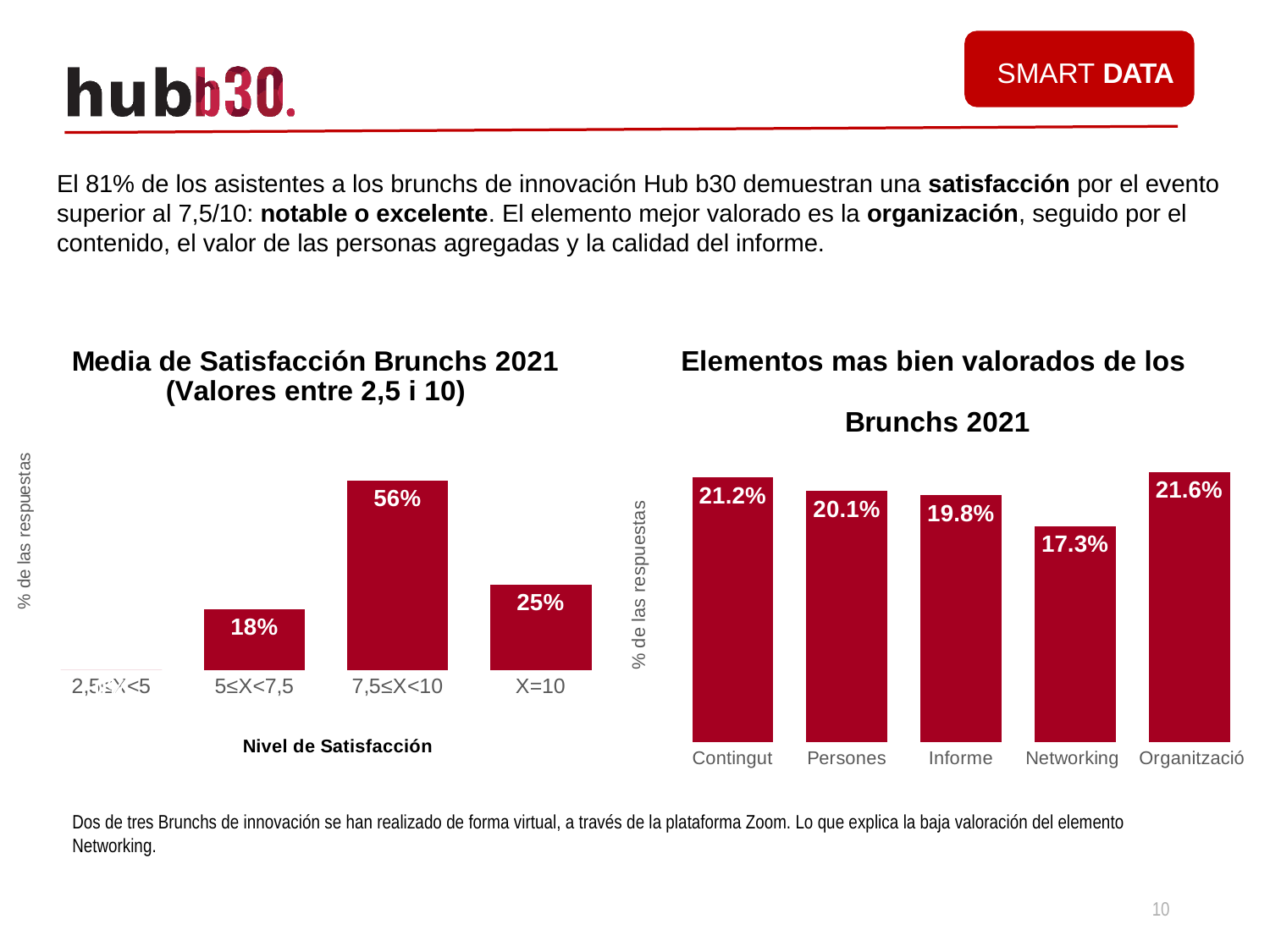
In the 'Elementos mas bien valorados de los Brunchs 2021' chart, what is the value for Informe? 19.8% In the 'Elementos mas bien valorados de los Brunchs 2021' chart, what is the value for Networking? 17.3% In the 'Elementos mas bien valorados de los Brunchs 2021' chart, which element has the highest value? Organització In the 'Media de Satisfacción Brunchs 2021' chart, what percentage of responses fall in the 7,5≤X<10 category? 56% In the 'Media de Satisfacción Brunchs 2021' chart, what is the value for the X=10 category? 25% In the 'Media de Satisfacción Brunchs 2021' chart, what is the difference between the 7,5≤X<10 and 5≤X<7,5 values? 38% In the 'Elementos mas bien valorados de los Brunchs 2021' chart, which element has the lowest value? Networking In the 'Media de Satisfacción Brunchs 2021' chart, which satisfaction level has the highest percentage of responses? 7,5≤X<10 In the 'Elementos mas bien valorados de los Brunchs 2021' chart, how many elements are shown? 5 In the 'Elementos mas bien valorados de los Brunchs 2021' chart, what is the difference between Organització and Networking? 4.3% What kind of chart is 'Media de Satisfacción Brunchs 2021'? Bar chart In the 'Media de Satisfacción Brunchs 2021' chart, which is larger: the value for 5≤X<7,5 or the value for X=10? X=10